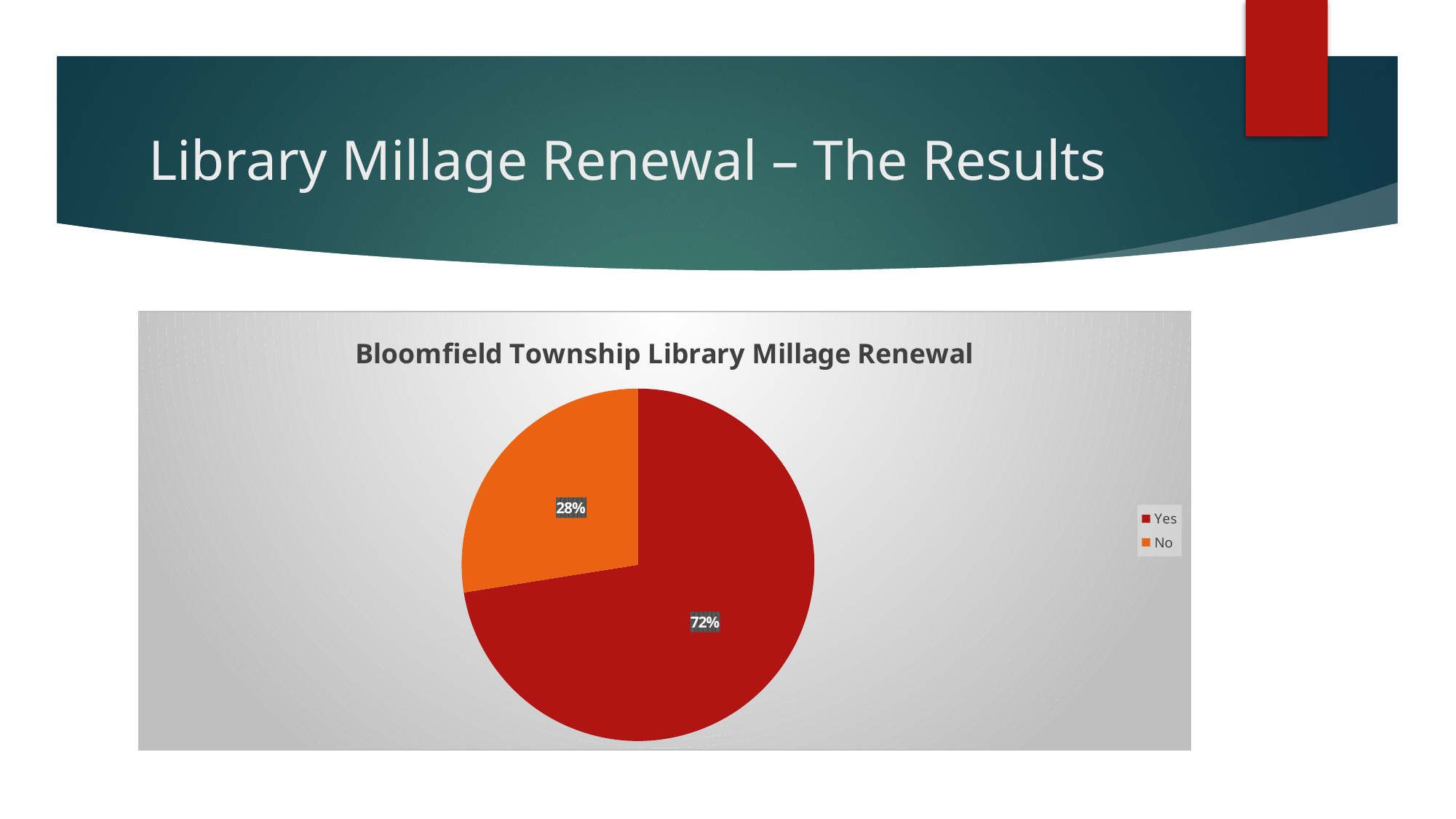
Which is larger, the Yes slice or the No slice? Yes What share of the pie is the No slice? 28% How many entries does the legend list? 2 Which slice is the largest? Yes What is the difference in percentage points between the Yes and No slices? 44 How many slices does the pie chart have? 2 Which slice is the smallest? No What is the chart's title? Bloomfield Township Library Millage Renewal What share of the pie is the Yes slice? 72% What colour is the No slice? orange What kind of chart is shown on the slide? pie chart